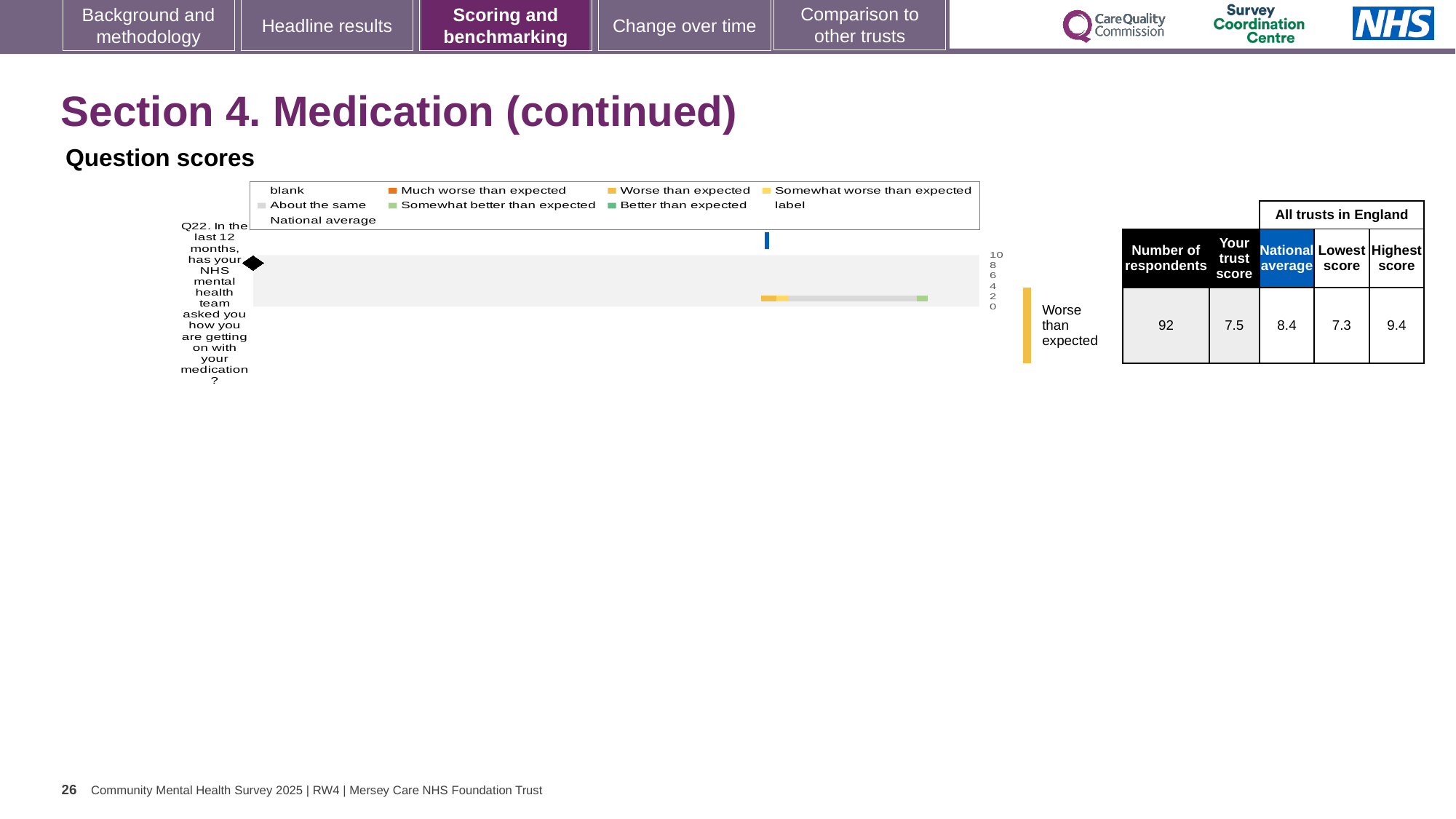
How many respondents answered Q22? 92 What is the highest score across all trusts in England for Q22? 9.4 What is the lowest score across all trusts in England for Q22? 7.3 What is the trust score for Q22 shown in the table next to the chart? 7.5 How many questions are plotted on the chart? 1 What is the national average for Q22 shown in the table next to the chart? 8.4 What is the highest value shown on the chart's score axis? 10 Which question is plotted on the chart? Q22. In the last 12 months, has your NHS mental health team asked you how you are getting on with your medication? What benchmark category label is shown to the right of the chart for Q22? Worse than expected What kind of chart is used to show the question score for Q22? bar chart Which is larger for Q22, the trust score or the national average? national average What is the difference between the national average and the trust score for Q22? 0.9